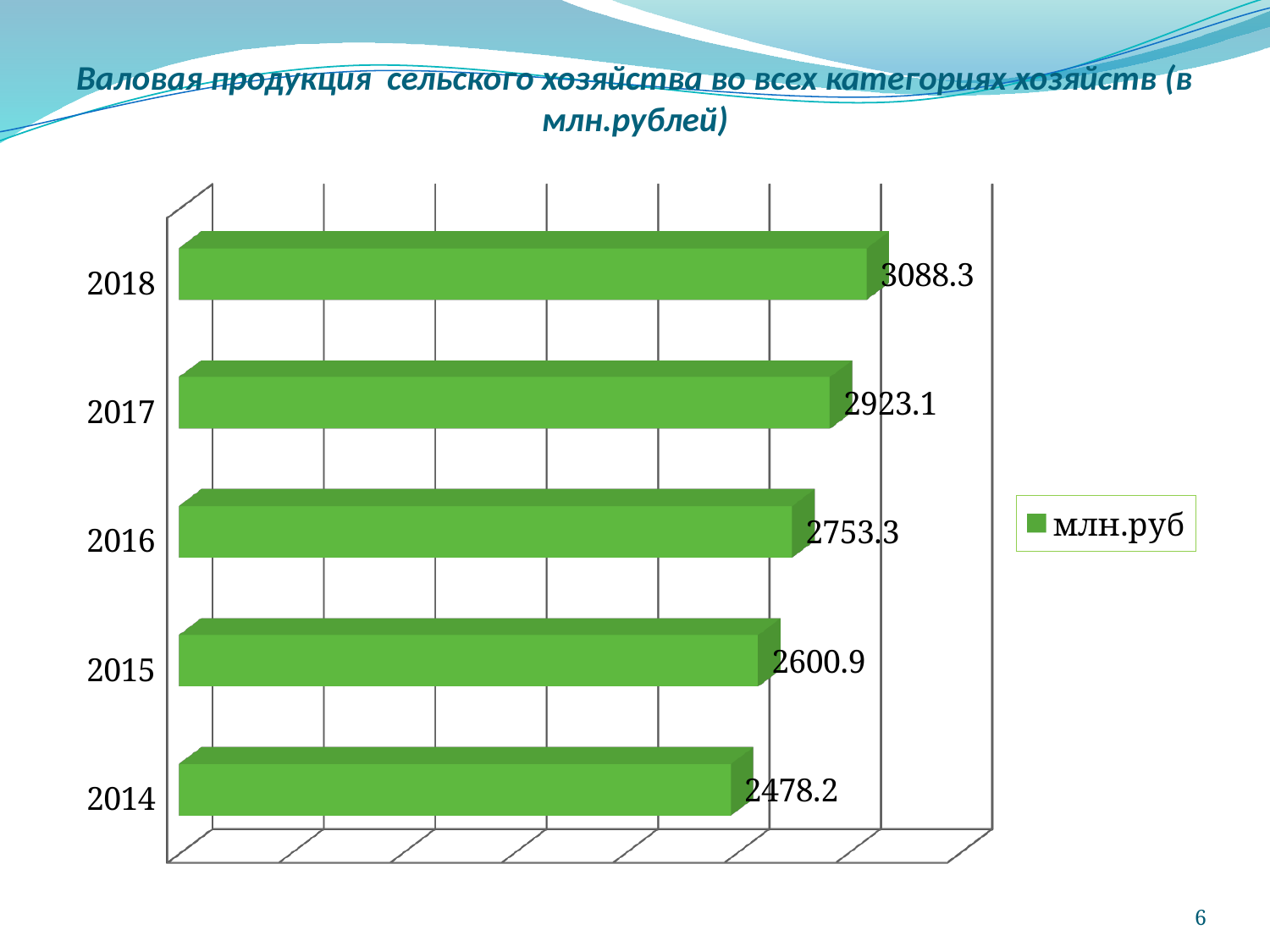
Which is larger, the value for 2015 or the value for 2016? 2016 What is the difference between the values for 2018 and 2017? 165.2 How many years are shown in the chart? 5 How many series does the legend list? 1 What is the value for 2014? 2478.2 What is the value for 2018? 3088.3 Which year has the highest value? 2018 What is the value for 2016? 2753.3 Which year has the lowest value? 2014 Do the values rise or fall from 2014 to 2018? rise What kind of chart is shown on the slide? bar chart What is the difference between the values for 2018 and 2014? 610.1